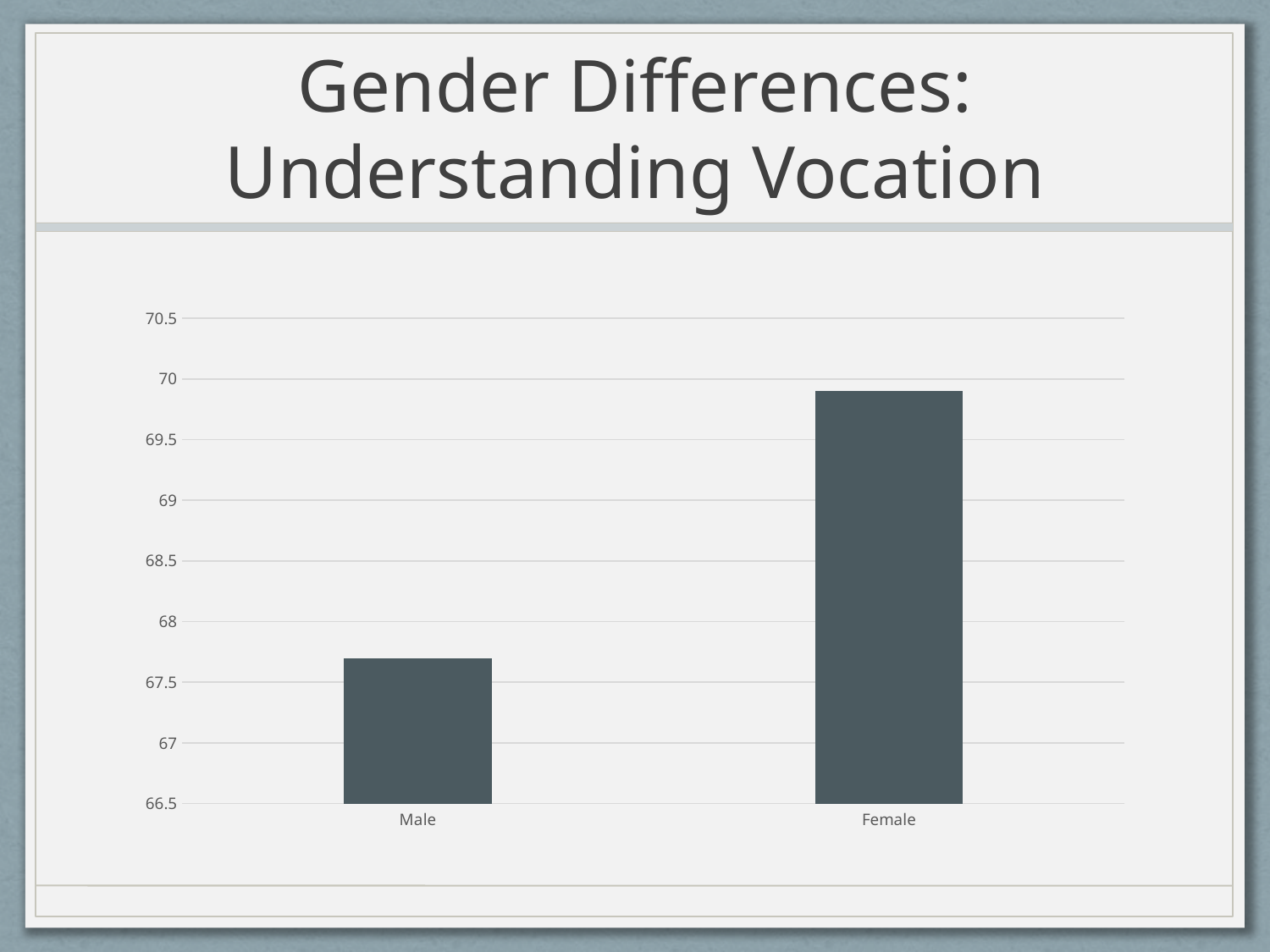
Is the value for Male greater or less than 68? less What is the lowest value shown on the vertical axis? 66.5 Which category has the lowest value? Male Is the value for Female greater or less than 69.5? greater What is the title of the slide containing the chart? Gender Differences: Understanding Vocation What kind of chart is shown on the slide? bar chart How many categories are plotted on the chart? 2 Which category has the highest value? Female Which is larger, the value for Male or the value for Female? Female Is the value for Male greater or less than 67.5? greater